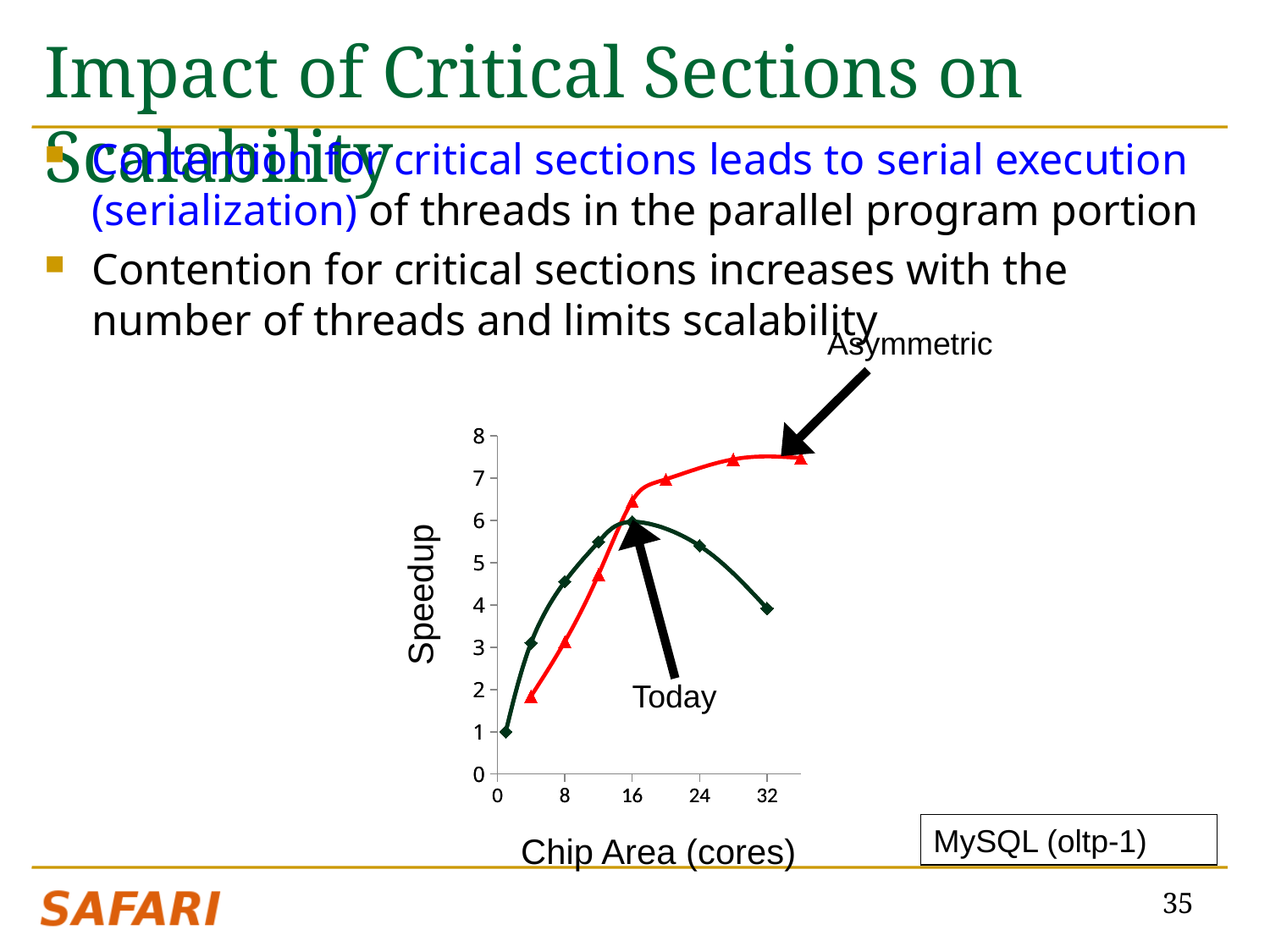
Is the speedup of the Today curve at 24 cores greater or less than 5? greater What is the label of the x axis of the chart? Chip Area (cores) Is the speedup of the Today curve at 8 cores greater or less than 4? greater At 32 cores, which curve has the higher speedup, Today or Asymmetric? Asymmetric Is the speedup of the Today curve at 32 cores greater or less than 3? greater What kind of chart is shown on the slide? line chart Does the speedup of the Asymmetric curve rise or fall as chip area increases from 8 to 32 cores? rise What is the label of the y axis of the chart? Speedup At 8 cores, which curve has the higher speedup, Today or Asymmetric? Today